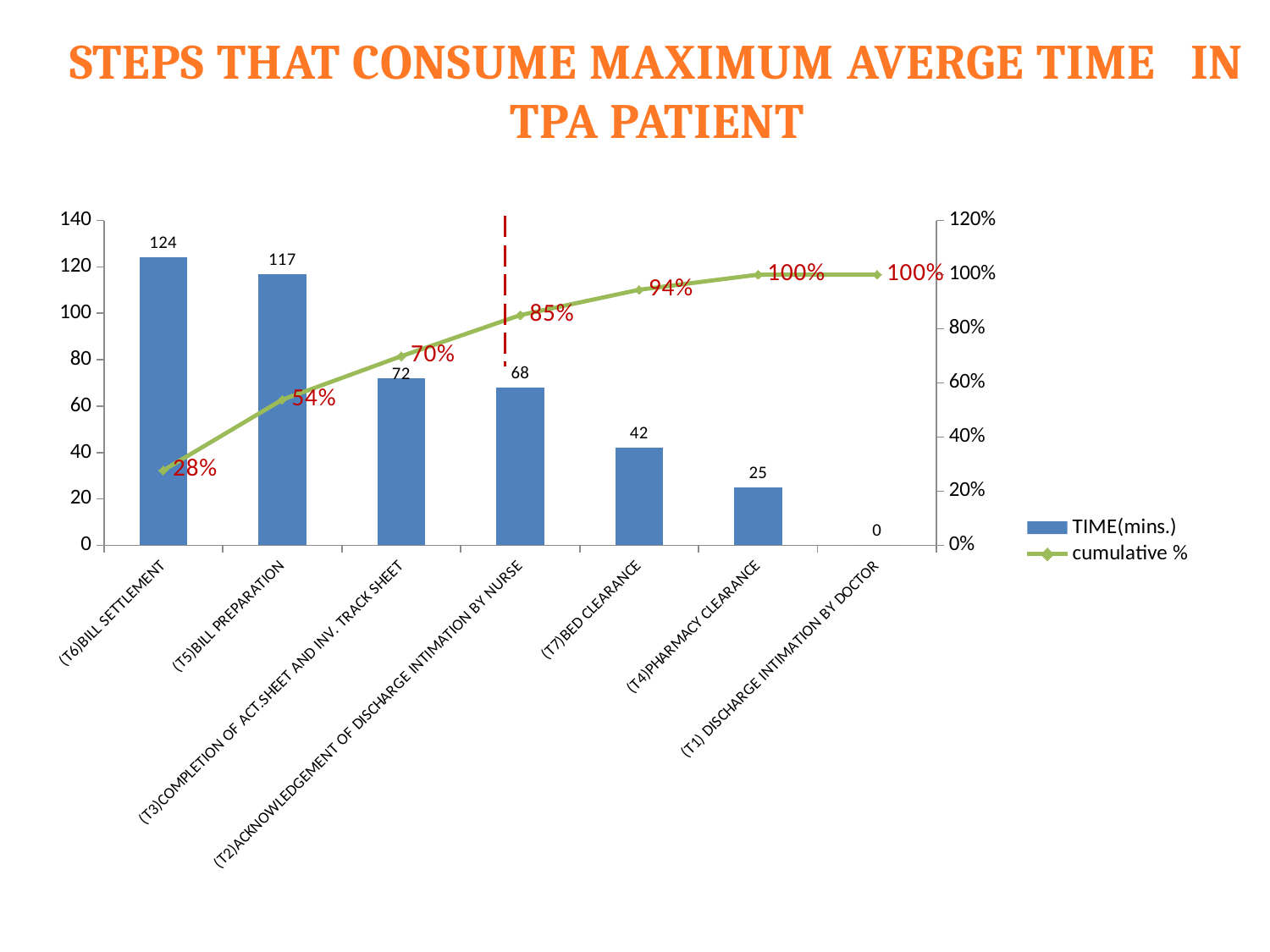
Which step has the highest TIME(mins.) value? (T6)BILL SETTLEMENT Which step has the lowest TIME(mins.) value? (T1) DISCHARGE INTIMATION BY DOCTOR Which has a larger TIME(mins.) value, (T3)COMPLETION OF ACT.SHEET AND INV. TRACK SHEET or (T7)BED CLEARANCE? (T3)COMPLETION OF ACT.SHEET AND INV. TRACK SHEET Does the TIME(mins.) value rise or fall from left to right along the x axis? fall How many steps are shown on the x axis? 7 How many series does the legend list? 2 What is the cumulative % at (T3)COMPLETION OF ACT.SHEET AND INV. TRACK SHEET? 70% What is the title of the chart? STEPS THAT CONSUME MAXIMUM AVERGE TIME IN TPA PATIENT What is the cumulative % at (T2)ACKNOWLEDGEMENT OF DISCHARGE INTIMATION BY NURSE? 85% What is the difference in TIME(mins.) between (T5)BILL PREPARATION and (T4)PHARMACY CLEARANCE? 92 What is the TIME(mins.) value for (T7)BED CLEARANCE? 42 What is the TIME(mins.) value for (T6)BILL SETTLEMENT? 124